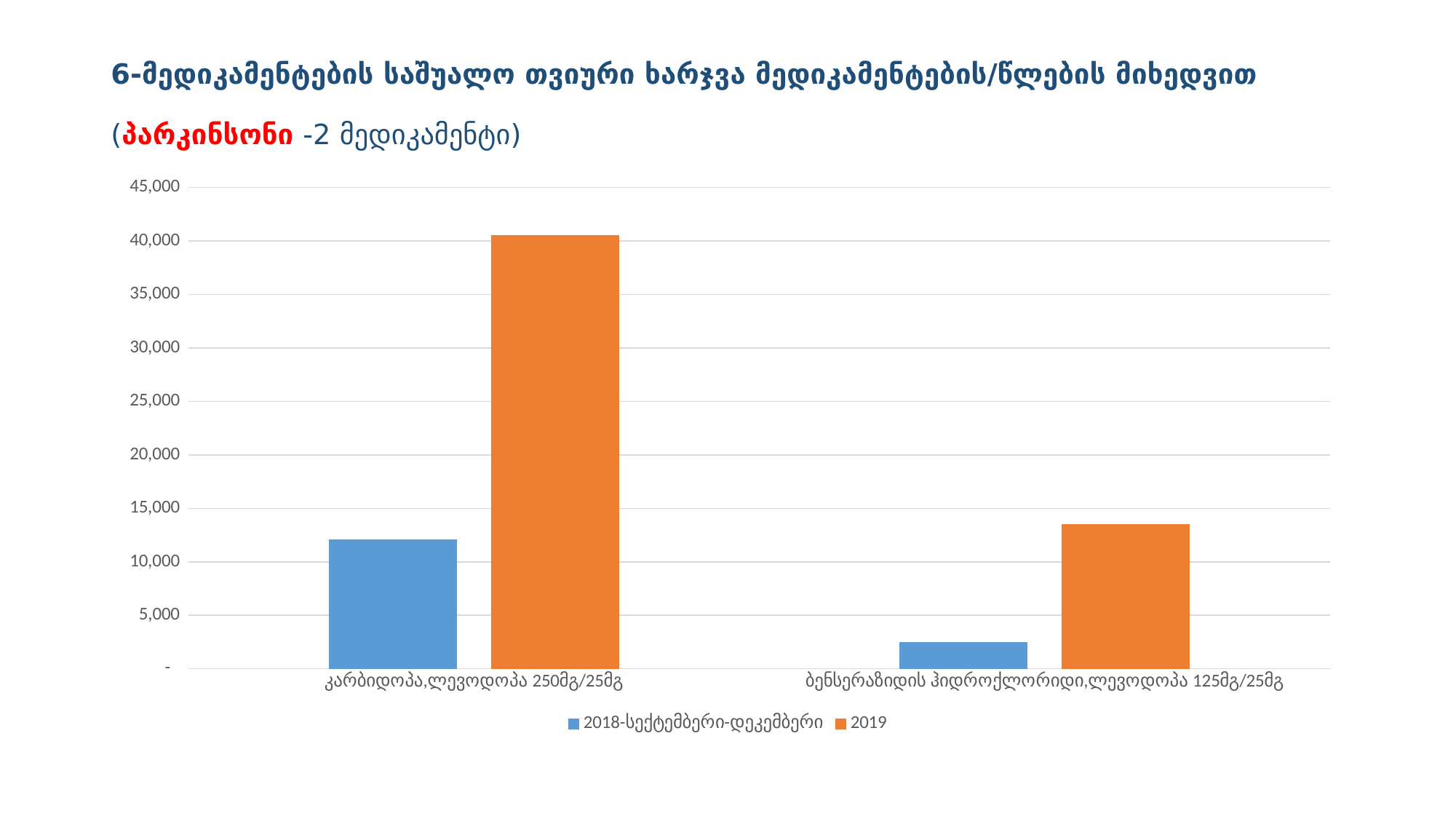
Is the 2019 value for კარბიდოპა,ლევოდოპა 250მგ/25მგ greater or less than 35,000? greater Is the 2019 value for ბენსერაზიდის ჰიდროქლორიდი,ლევოდოპა 125მგ/25მგ greater or less than 15,000? less What is the name of the series shown in blue in the chart? 2018-სექტემბერი-დეკემბერი Is the 2018-სექტემბერი-დეკემბერი value for ბენსერაზიდის ჰიდროქლორიდი,ლევოდოპა 125მგ/25მგ greater or less than 5,000? less How many categories are shown on the x axis of the chart? 2 How many series does the chart's legend list? 2 For კარბიდოპა,ლევოდოპა 250მგ/25მგ, which series has the larger value, 2018-სექტემბერი-დეკემბერი or 2019? 2019 Which category has the lowest 2018-სექტემბერი-დეკემბერი value? ბენსერაზიდის ჰიდროქლორიდი,ლევოდოპა 125მგ/25მგ Which series is shown in orange in the chart? 2019 What kind of chart is shown on the slide? bar chart Which category has the highest 2019 value? კარბიდოპა,ლევოდოპა 250მგ/25მგ